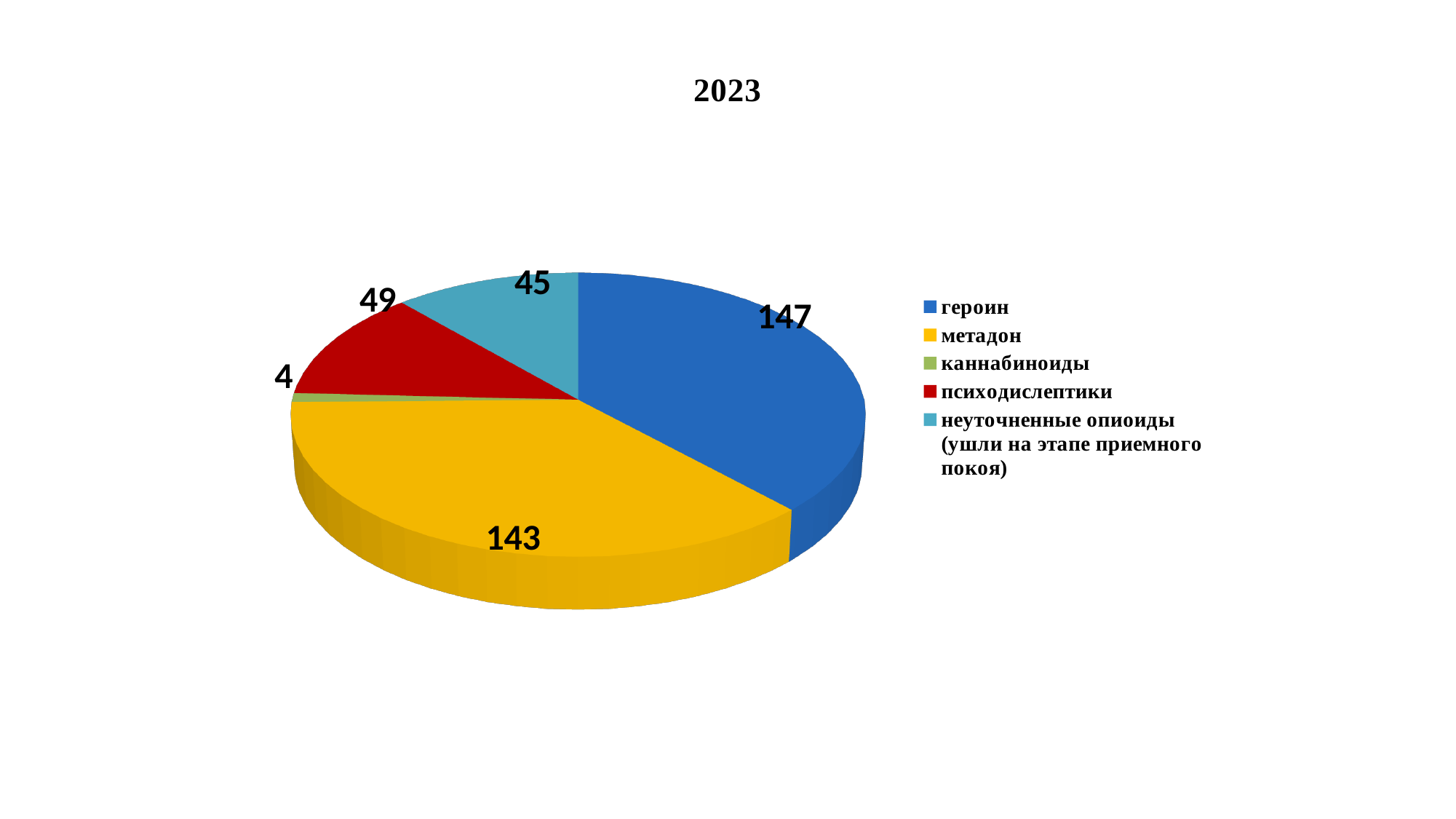
What is the title of the chart? 2023 What is the value for героин? 147 What is the value for метадон? 143 What colour is the slice for героин? blue What type of chart is shown on the slide? pie chart Which category has the smallest slice? каннабиноиды Which is larger, психодислептики or неуточненные опиоиды (ушли на этапе приемного покоя)? психодислептики How many categories does the pie chart have? 5 Which category has the largest slice? героин What is the difference between the values for героин and метадон? 4 What is the value for психодислептики? 49 What is the value for каннабиноиды? 4